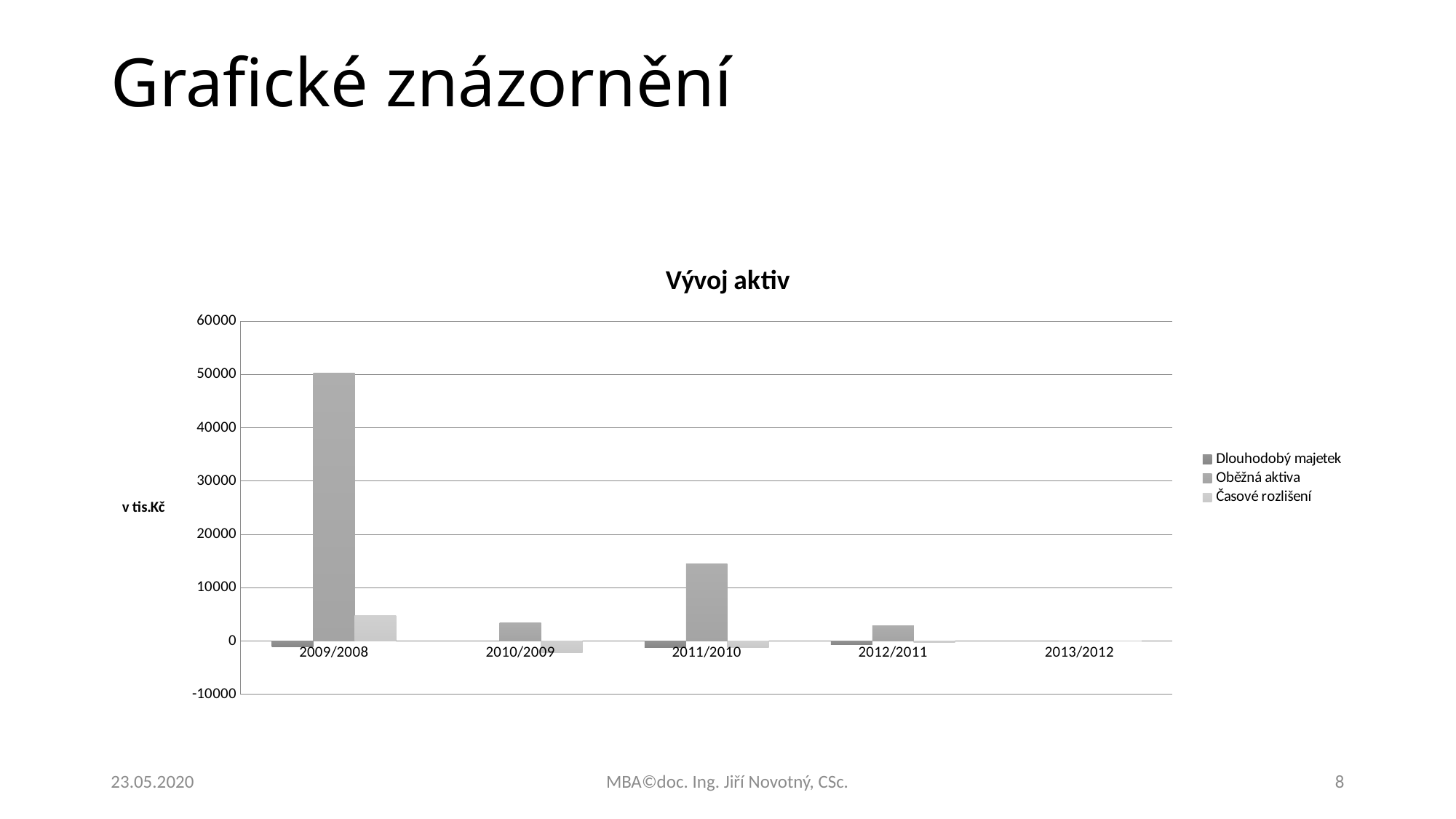
Is the value for Oběžná aktiva in 2011/2010 greater or less than 10000? greater How many categories are shown on the x axis? 5 What type of chart is shown on the slide? bar chart What unit label is shown on the vertical axis? v tis.Kč Is the value for Časové rozlišení in 2009/2008 greater or less than 10000? less Which is larger: Oběžná aktiva in 2011/2010 or Oběžná aktiva in 2010/2009? 2011/2010 Is the value for Oběžná aktiva in 2011/2010 greater or less than 20000? less Which is larger in 2009/2008: Oběžná aktiva or Časové rozlišení? Oběžná aktiva What is the title of the chart? Vývoj aktiv How many series does the legend list? 3 In which category is the value for Oběžná aktiva highest? 2009/2008